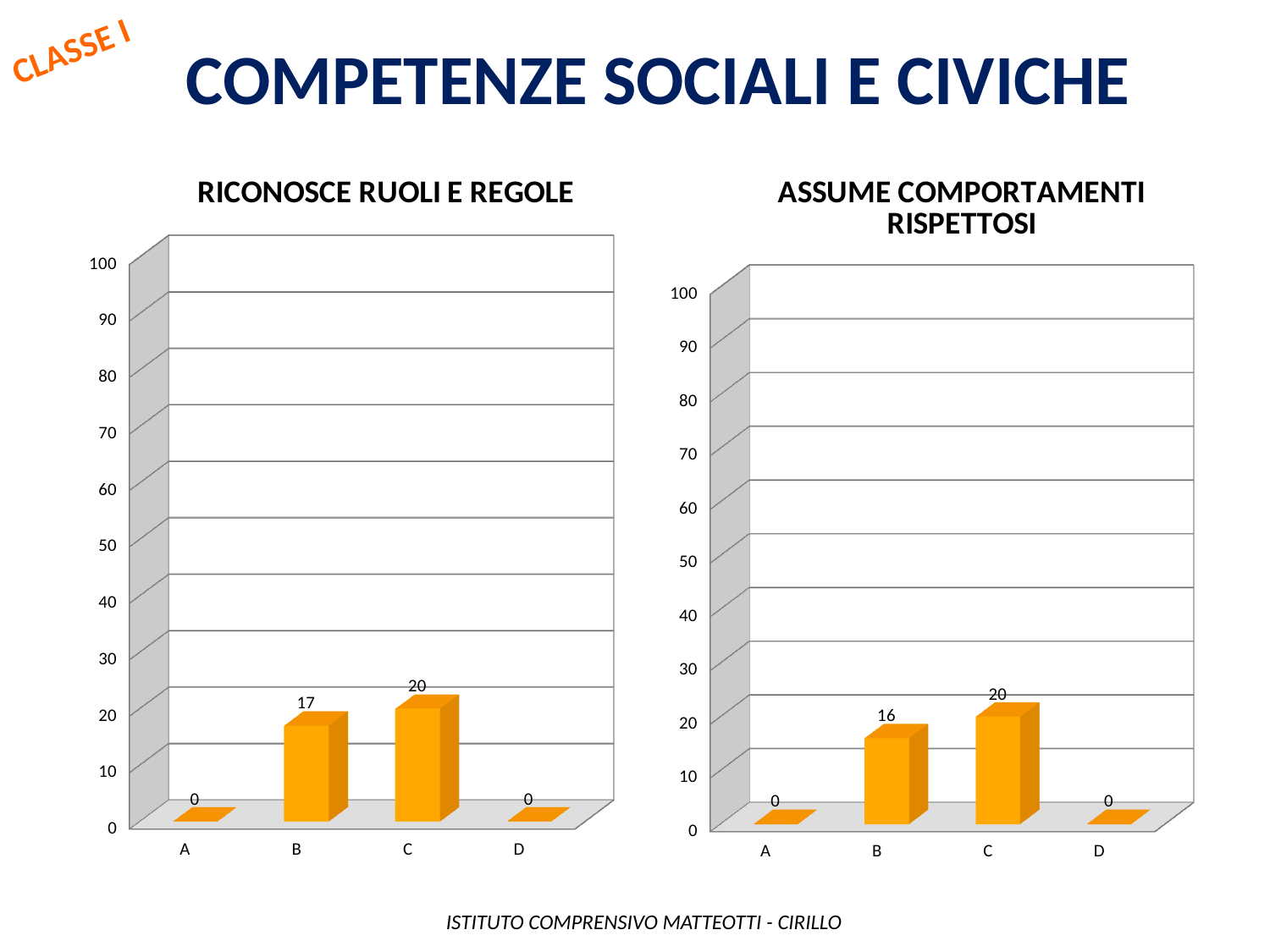
In the 'RICONOSCE RUOLI E REGOLE' chart, what is the value for category C? 20 What is the title of the chart on the left of the slide? RICONOSCE RUOLI E REGOLE In the 'RICONOSCE RUOLI E REGOLE' chart, which category has the highest value? C How many categories are shown on the x axis of the 'RICONOSCE RUOLI E REGOLE' chart? 4 What kind of chart is the 'ASSUME COMPORTAMENTI RISPETTOSI' chart? Bar chart In the 'ASSUME COMPORTAMENTI RISPETTOSI' chart, which category has the highest value? C In the 'ASSUME COMPORTAMENTI RISPETTOSI' chart, what is the value for category D? 0 In the 'ASSUME COMPORTAMENTI RISPETTOSI' chart, what is the value for category B? 16 In the 'ASSUME COMPORTAMENTI RISPETTOSI' chart, what is the difference between the values for C and B? 4 In the 'RICONOSCE RUOLI E REGOLE' chart, what is the value for category B? 17 In the 'RICONOSCE RUOLI E REGOLE' chart, what is the difference between the values for C and B? 3 In the 'ASSUME COMPORTAMENTI RISPETTOSI' chart, which is larger, the value for B or the value for C? C